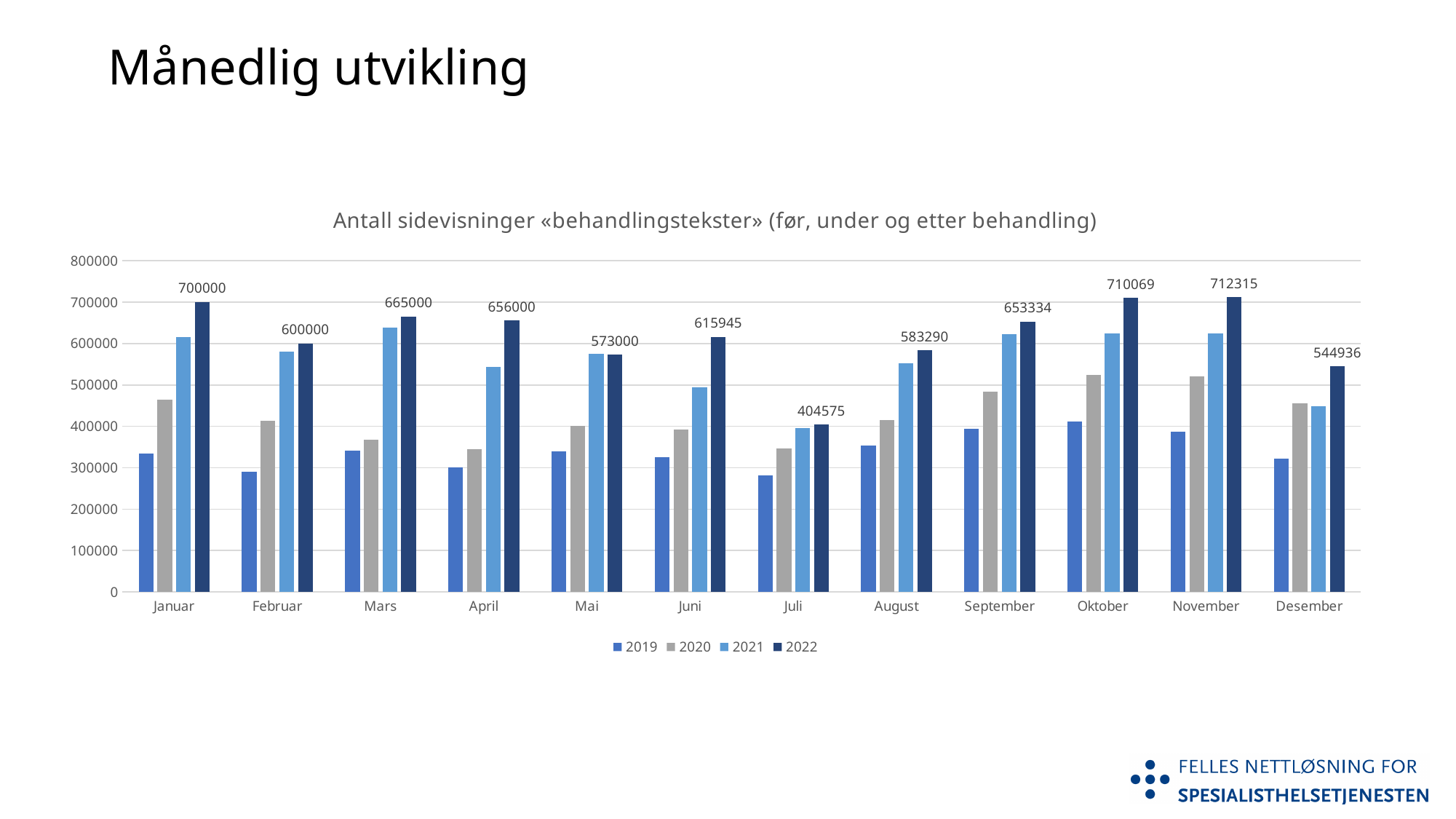
What kind of chart is shown on the slide? Bar chart Is the value for 2020 in Oktober greater or less than 500000? greater In which month is the 2022 value highest? November In which month is the 2022 value lowest? Juli What is the value for 2022 in Januar? 700000 How many months are shown on the x axis? 12 What is the difference between the 2022 values for Januar and Februar? 100000 What is the value for 2022 in Desember? 544936 Is the value for 2019 in Januar greater or less than 400000? less What is the value for 2022 in Juli? 404575 Which is larger, the 2022 value for Mars or for April? Mars How many series does the legend list? 4